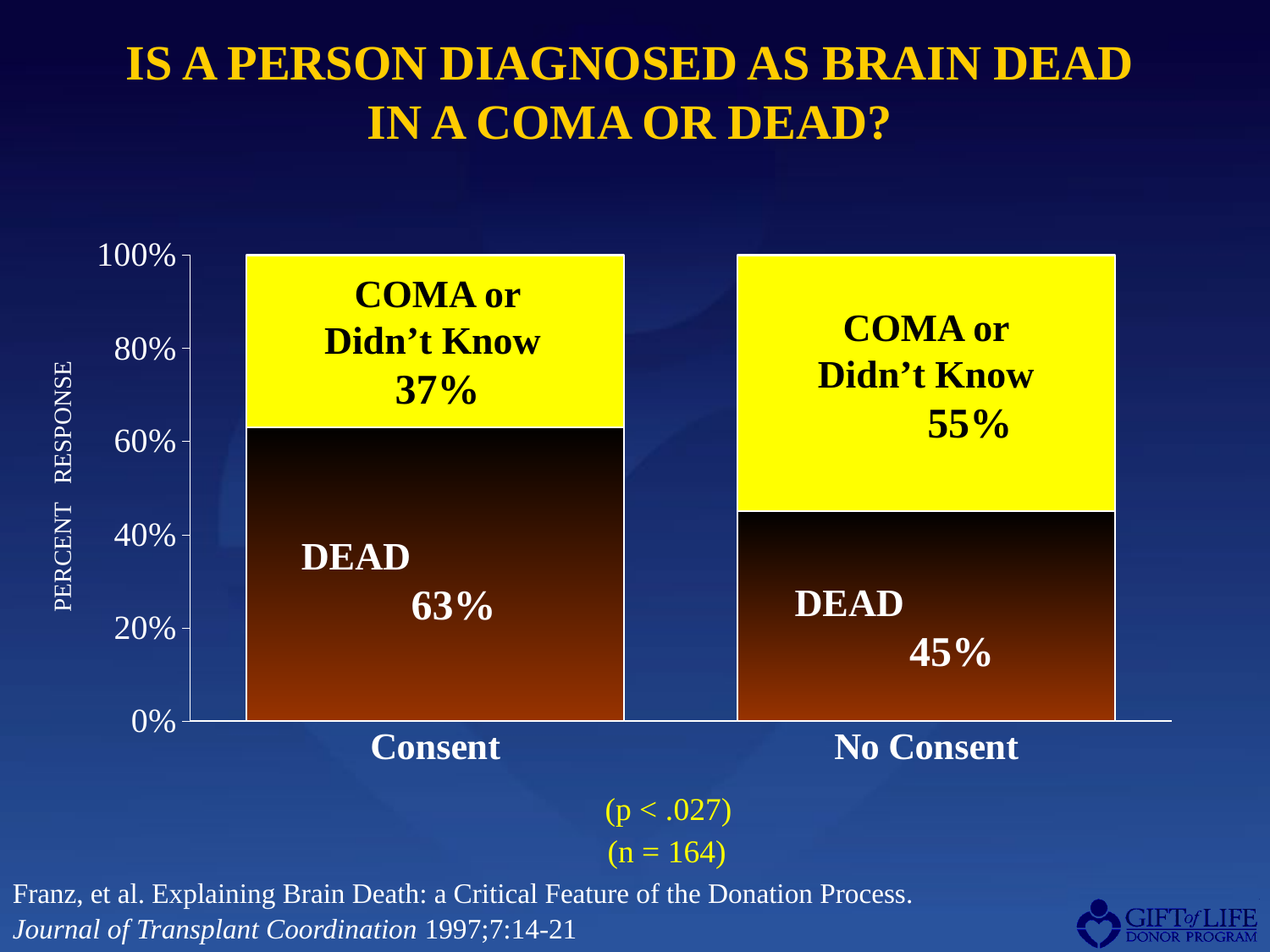
What percentage of the No Consent group responded DEAD? 45% What kind of chart is shown on the slide? Stacked bar chart What is the label of the y axis? PERCENT RESPONSE What percentage of the Consent group responded COMA or Didn't Know? 37% Which group has the higher DEAD response, Consent or No Consent? Consent How many groups (categories) are shown on the x axis? 2 What percentage of the Consent group responded DEAD? 63% What is the difference between the DEAD response for Consent and for No Consent? 18% What is the difference between the COMA or Didn't Know response for No Consent and for Consent? 18% What is the sample size (n) shown below the chart? n = 164 What percentage of the No Consent group responded COMA or Didn't Know? 55% What is the total of the stacked bar for the Consent group? 100%